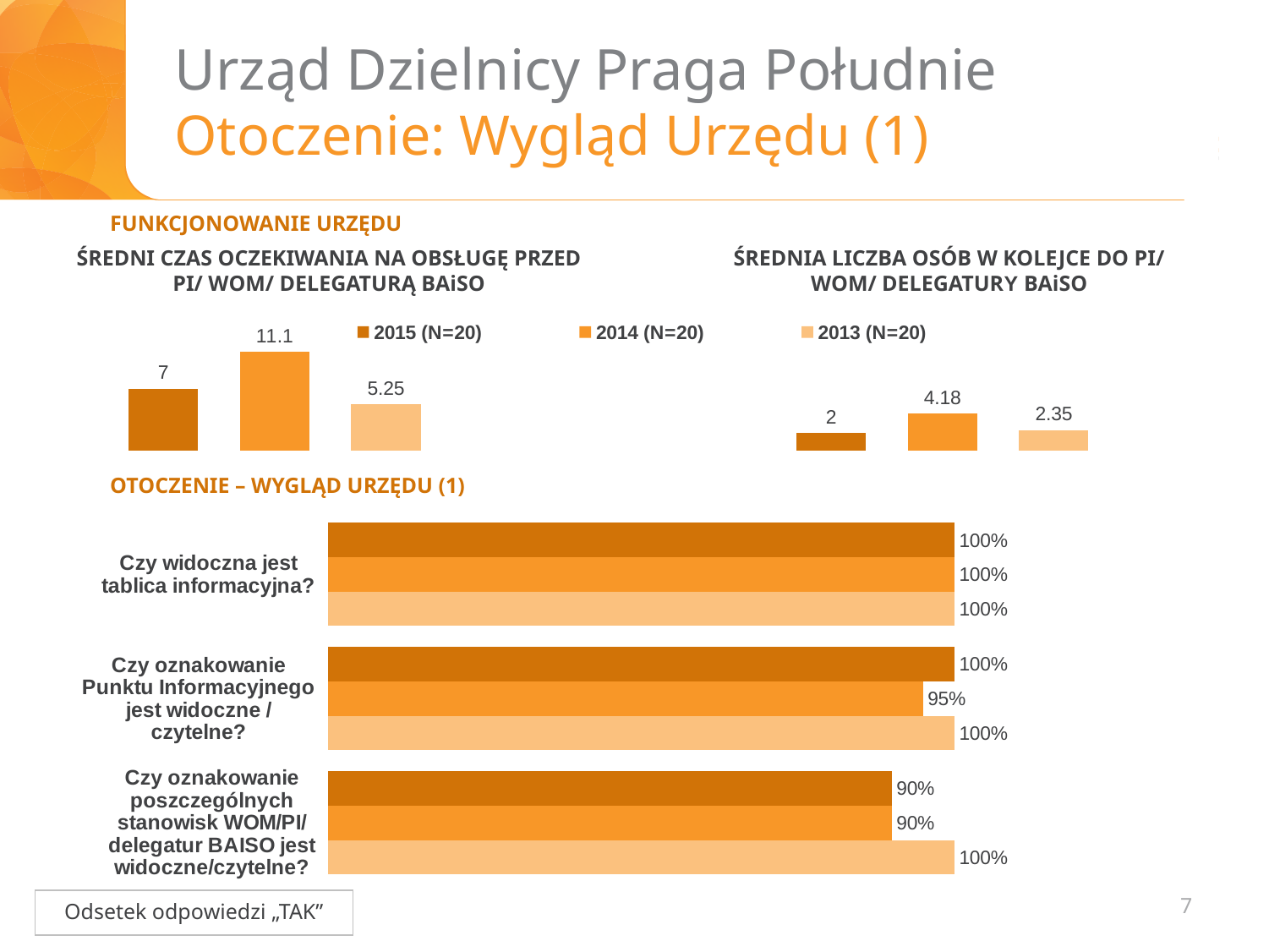
In the bottom chart 'OTOCZENIE – WYGLĄD URZĘDU (1)', what is the 2015 value for 'Czy oznakowanie poszczególnych stanowisk WOM/PI/ delegatur BAISO jest widoczne/czytelne?'? 90% In the bottom chart 'OTOCZENIE – WYGLĄD URZĘDU (1)', what is the 2014 value for 'Czy oznakowanie Punktu Informacyjnego jest widoczne / czytelne?'? 95% In the chart 'ŚREDNIA LICZBA OSÓB W KOLEJCE DO PI/ WOM/ DELEGATURY BAiSO', which year has the lowest value? 2015 (N=20) In the chart 'ŚREDNI CZAS OCZEKIWANIA NA OBSŁUGĘ PRZED PI/ WOM/ DELEGATURĄ BAiSO', which year has the highest value? 2014 (N=20) In the chart 'ŚREDNIA LICZBA OSÓB W KOLEJCE DO PI/ WOM/ DELEGATURY BAiSO', what is the value for 2013 (N=20)? 2.35 What kind of chart is the bottom chart 'OTOCZENIE – WYGLĄD URZĘDU (1)'? Bar chart How many series does the legend list for the top charts? 3 In the chart 'ŚREDNIA LICZBA OSÓB W KOLEJCE DO PI/ WOM/ DELEGATURY BAiSO', which is larger: the 2014 value or the 2015 value? 2014 (N=20) In the chart 'ŚREDNI CZAS OCZEKIWANIA NA OBSŁUGĘ PRZED PI/ WOM/ DELEGATURĄ BAiSO', what is the difference between the 2014 and 2013 values? 5.85 In the chart 'ŚREDNI CZAS OCZEKIWANIA NA OBSŁUGĘ PRZED PI/ WOM/ DELEGATURĄ BAiSO', what is the value for 2014 (N=20)? 11.1 In the bottom chart 'OTOCZENIE – WYGLĄD URZĘDU (1)', what is the difference between the 2013 and 2015 values for 'Czy oznakowanie poszczególnych stanowisk WOM/PI/ delegatur BAISO jest widoczne/czytelne?'? 10% In the bottom chart 'OTOCZENIE – WYGLĄD URZĘDU (1)', how many question categories are shown? 3